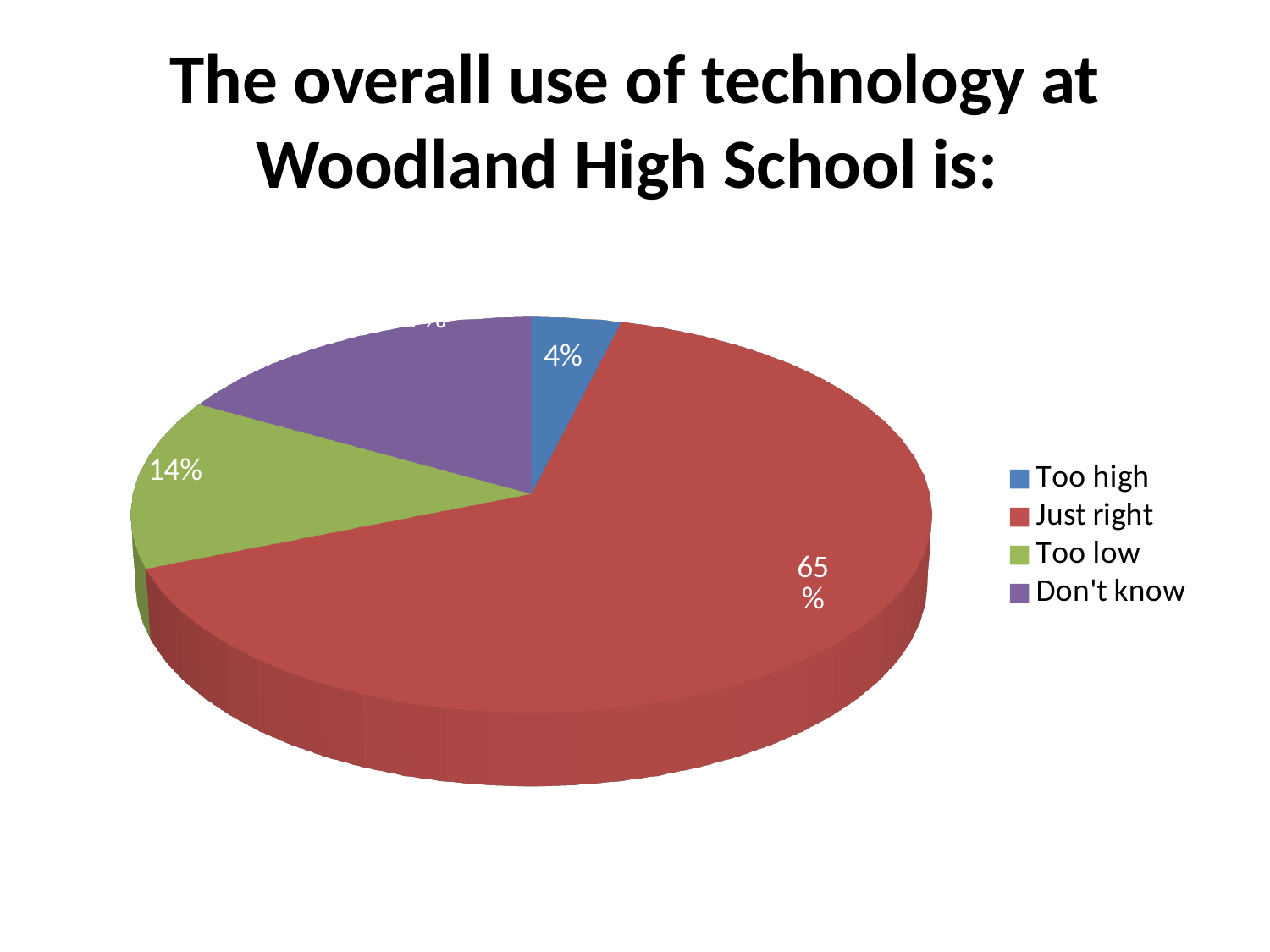
How many percentage points larger is the "Too low" share than the "Too high" share? 10 What percentage of respondents said the use of technology is "Too high"? 4% What percentage of respondents said the use of technology is "Just right"? 65% Which response has the largest share of the pie? Just right How many entries are listed in the legend? 4 Which response has the smallest share of the pie? Too high What colour is the "Just right" slice of the pie? red Which response has a larger share: "Too low" or "Too high"? Too low What kind of chart is shown on the slide? pie chart What percentage of respondents said the use of technology is "Too low"? 14% How many response categories does the pie chart show? 4 How many percentage points larger is the "Just right" share than the "Too low" share? 51